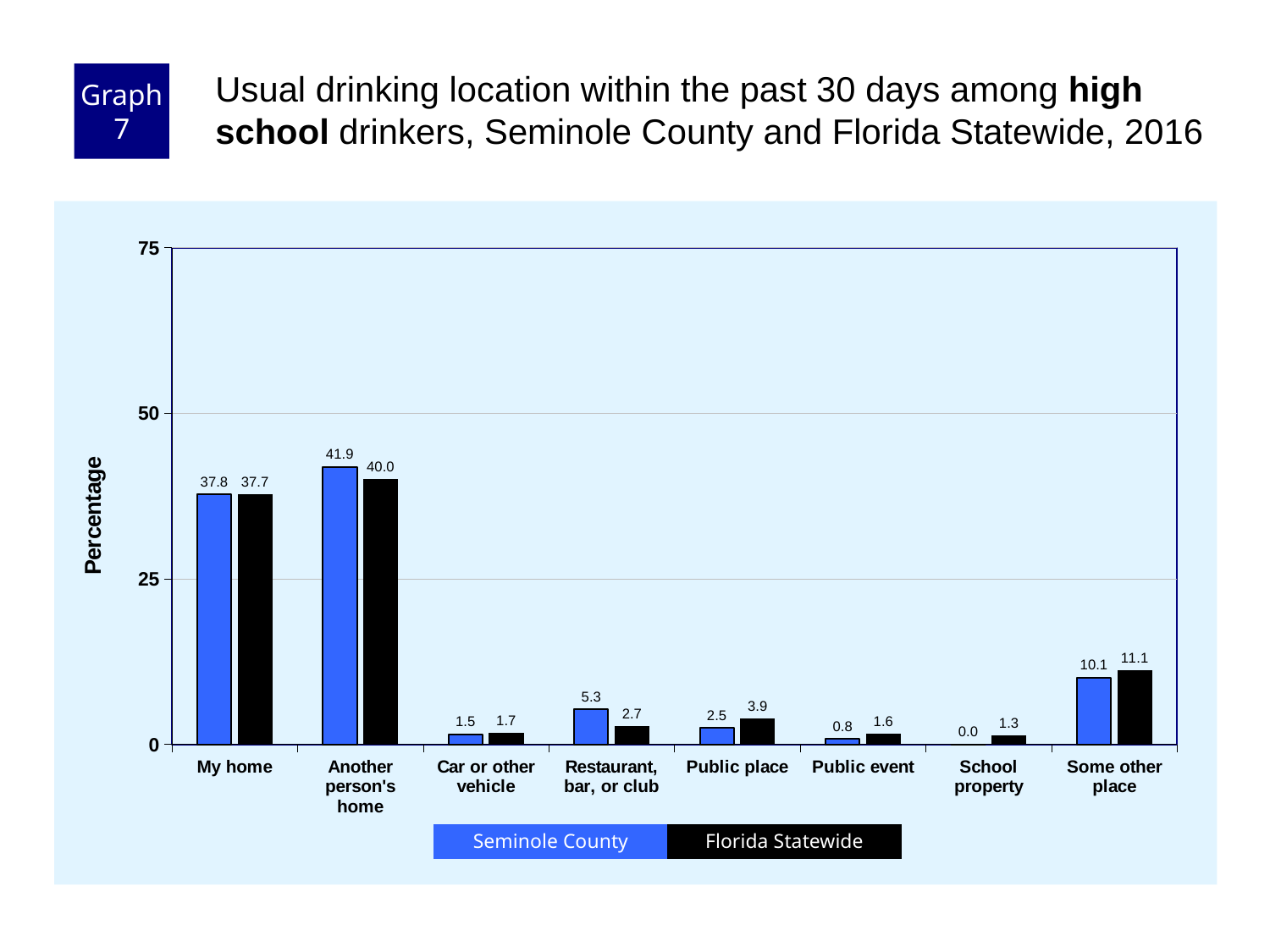
How many categories are shown on the x axis? 8 What is the Seminole County value for "School property"? 0.0 What is the label of the y axis? Percentage Which category has the lowest Florida Statewide value? School property What is the difference between the Seminole County and Florida Statewide values for "Restaurant, bar, or club"? 2.6 What is the Seminole County value for "Another person's home"? 41.9 For "Public place", which is larger: the Seminole County value or the Florida Statewide value? Florida Statewide What kind of chart is shown on the slide? bar chart What is the Florida Statewide value for "Some other place"? 11.1 Which category has the highest Seminole County value? Another person's home Is the Florida Statewide value for "Another person's home" greater or less than 50? less How many series does the legend list? 2